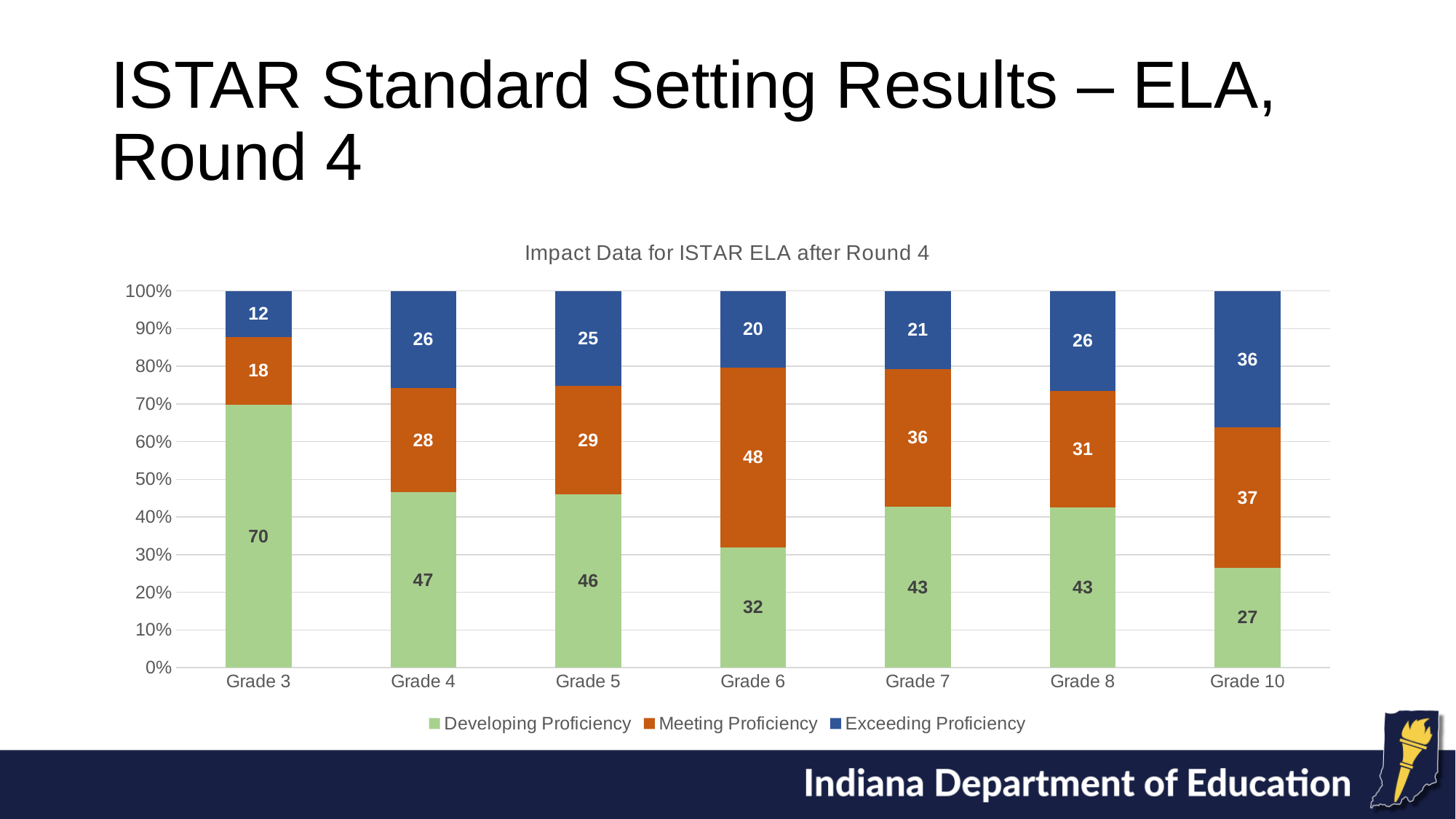
What is the Exceeding Proficiency value for Grade 10? 36 What kind of chart is shown on the slide? Stacked bar chart What is the difference between the Meeting Proficiency values for Grade 6 and Grade 3? 30 How many series does the legend list? 3 How many grades are shown on the x axis? 7 What is the Developing Proficiency value for Grade 6? 32 What is the title of the chart? Impact Data for ISTAR ELA after Round 4 What is the Meeting Proficiency value for Grade 5? 29 Which has the larger Meeting Proficiency value, Grade 7 or Grade 8? Grade 7 Which grade has the lowest Exceeding Proficiency value? Grade 3 Which grade has the highest Developing Proficiency value? Grade 3 Which grade has the highest Meeting Proficiency value? Grade 6